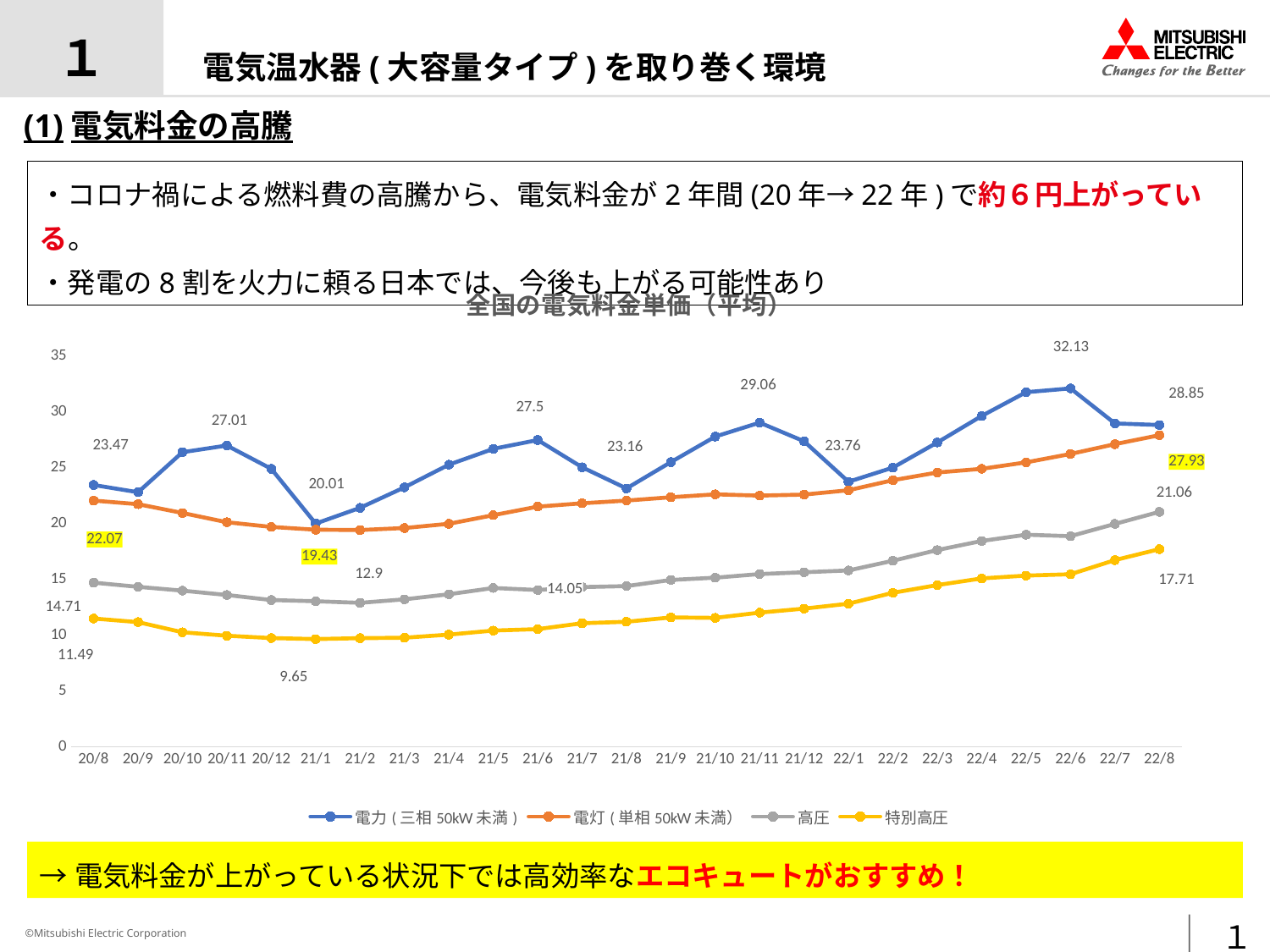
What is the difference between the 電灯(単相50kW未満) values at 22/8 and 20/8? 5.86 What is the title of the chart? 全国の電気料金単価（平均） What is the value of 電力(三相50kW未満) at 22/6? 32.13 How many series does the legend list? 4 How many points are on the x axis of the chart? 25 What type of chart is shown on the slide? line chart Is the value of 高圧 at 22/1 greater or less than 20? less Which series has the lowest value at 22/8? 特別高圧 What is the value of 高圧 at 22/8? 21.06 What is the value of 特別高圧 at 21/1? 9.65 What is the value of 電灯(単相50kW未満) at 22/8? 27.93 Which is larger at 22/8: 電力(三相50kW未満) or 電灯(単相50kW未満)? 電力(三相50kW未満)